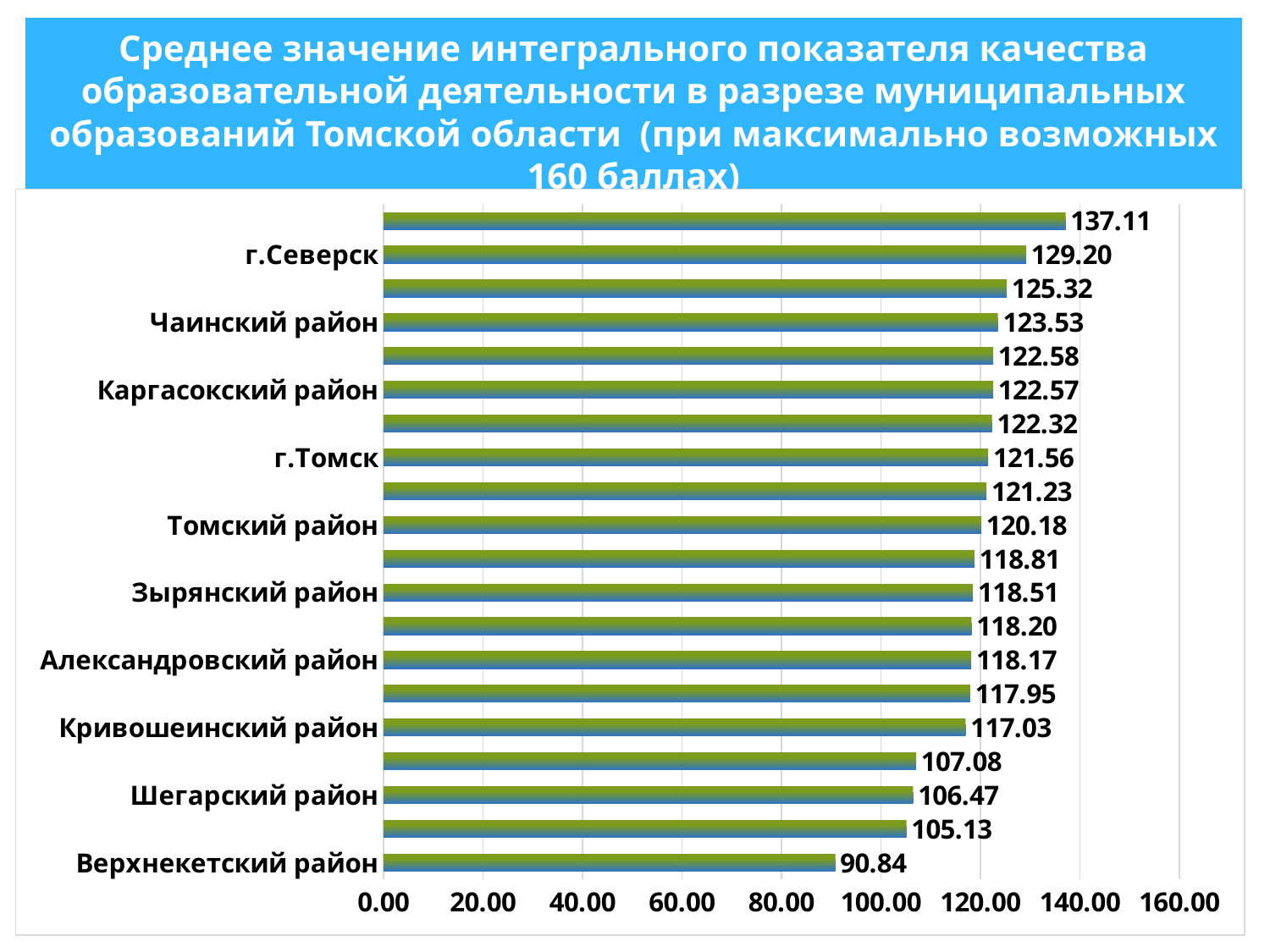
What is the value for Чаинский район? 123.53 Which labelled municipality has the lowest value? Верхнекетский район What is the value for Шегарский район? 106.47 What is the difference between the values for г.Северск and Верхнекетский район? 38.36 Which has a larger value, Томский район or Кривошеинский район? Томский район What is the value for г.Томск? 121.56 What is the value for Верхнекетский район? 90.84 What is the value for г.Северск? 129.20 What is the highest value shown on the chart? 137.11 What type of chart is shown on the slide? bar chart Is the value for Александровский район greater or less than 100.00? greater How many bars are plotted on the chart? 20